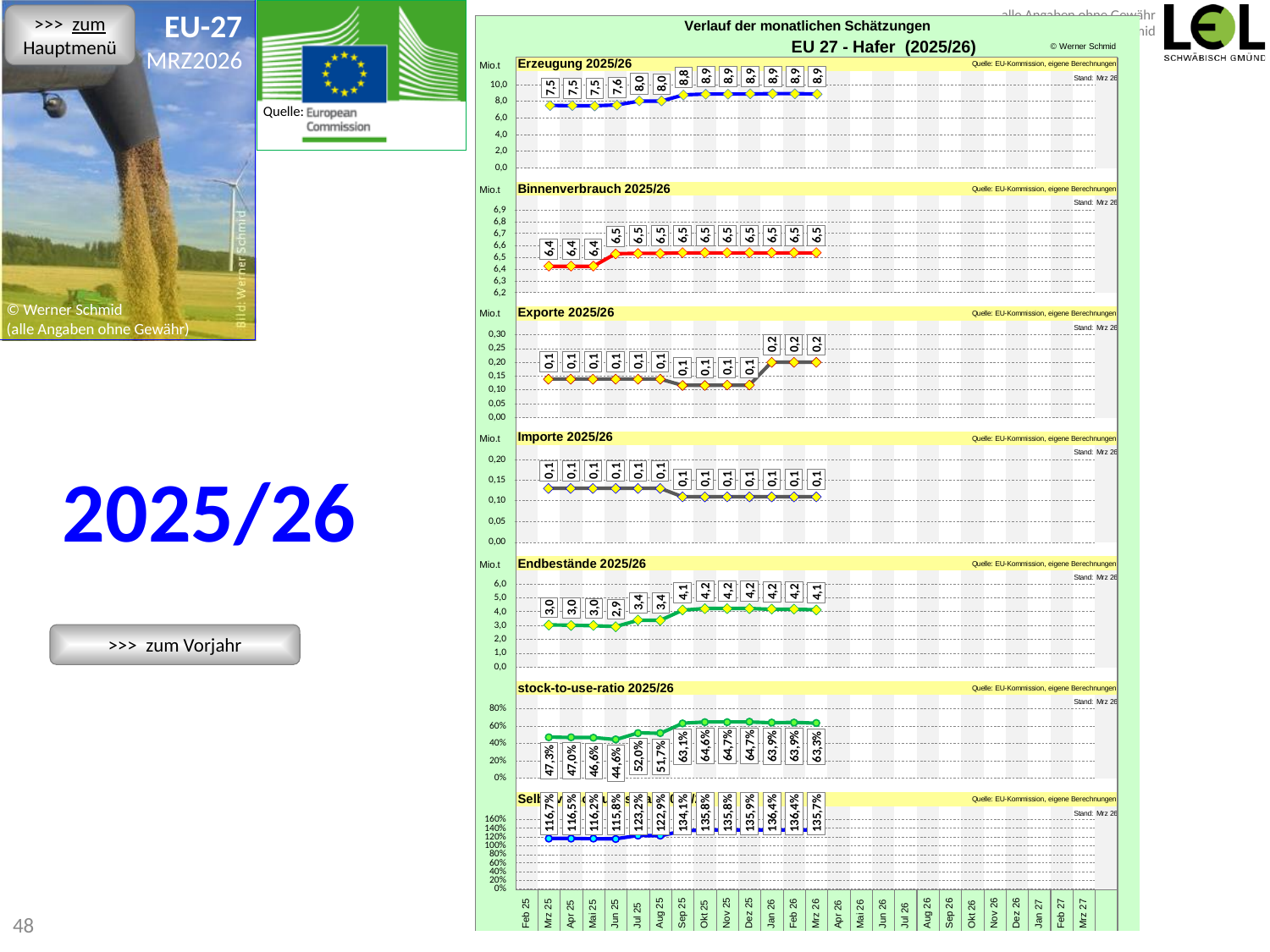
In the Erzeugung 2025/26 chart, do the values rise or fall from Mrz 25 to Mrz 26? rise In the bottom chart (Selbstversorgungsgrad), what is the value for Jan 26? 136,4% In the Endbestände 2025/26 chart, what is the value for Mrz 26? 4,1 In the Binnenverbrauch 2025/26 chart, what is the value for Mrz 25? 6,4 In the stock-to-use-ratio 2025/26 chart, which month has the lowest value? Jun 25 What kind of chart is the Erzeugung 2025/26 chart? line chart In the Erzeugung 2025/26 chart, what is the value for Mrz 26? 8,9 In the Endbestände 2025/26 chart, which month has the lowest value? Jun 25 In the stock-to-use-ratio 2025/26 chart, what is the value for Okt 25? 64,6% In the Erzeugung 2025/26 chart, what is the value for Mrz 25? 7,5 In the Erzeugung 2025/26 chart, what is the difference between the Mrz 26 value and the Mrz 25 value? 1,4 In the Exporte 2025/26 chart, what is the value for Mrz 26? 0,2